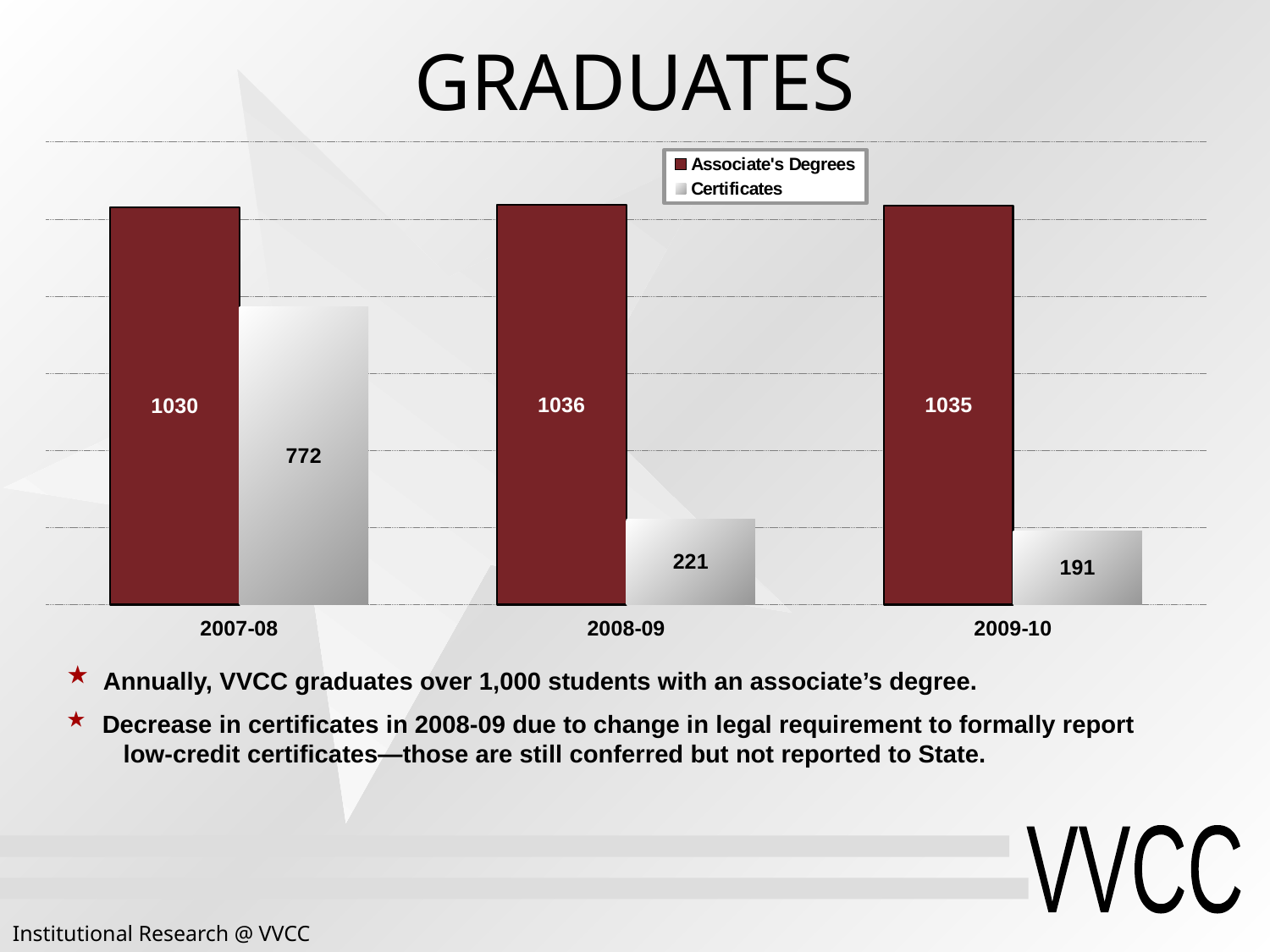
How many years are shown on the x axis? 3 What kind of chart is shown on the slide? Bar chart Which year has the highest value for Certificates? 2007-08 What is the difference between Certificates in 2007-08 and Certificates in 2008-09? 551 Which year has the lowest value for Certificates? 2009-10 What is the difference between Associate's Degrees and Certificates in 2009-10? 844 What is the value for Associate's Degrees in 2008-09? 1036 What is the value for Associate's Degrees in 2007-08? 1030 What is the value for Certificates in 2008-09? 221 Which is larger in 2008-09, Associate's Degrees or Certificates? Associate's Degrees What is the value for Certificates in 2009-10? 191 How many series does the legend list? 2